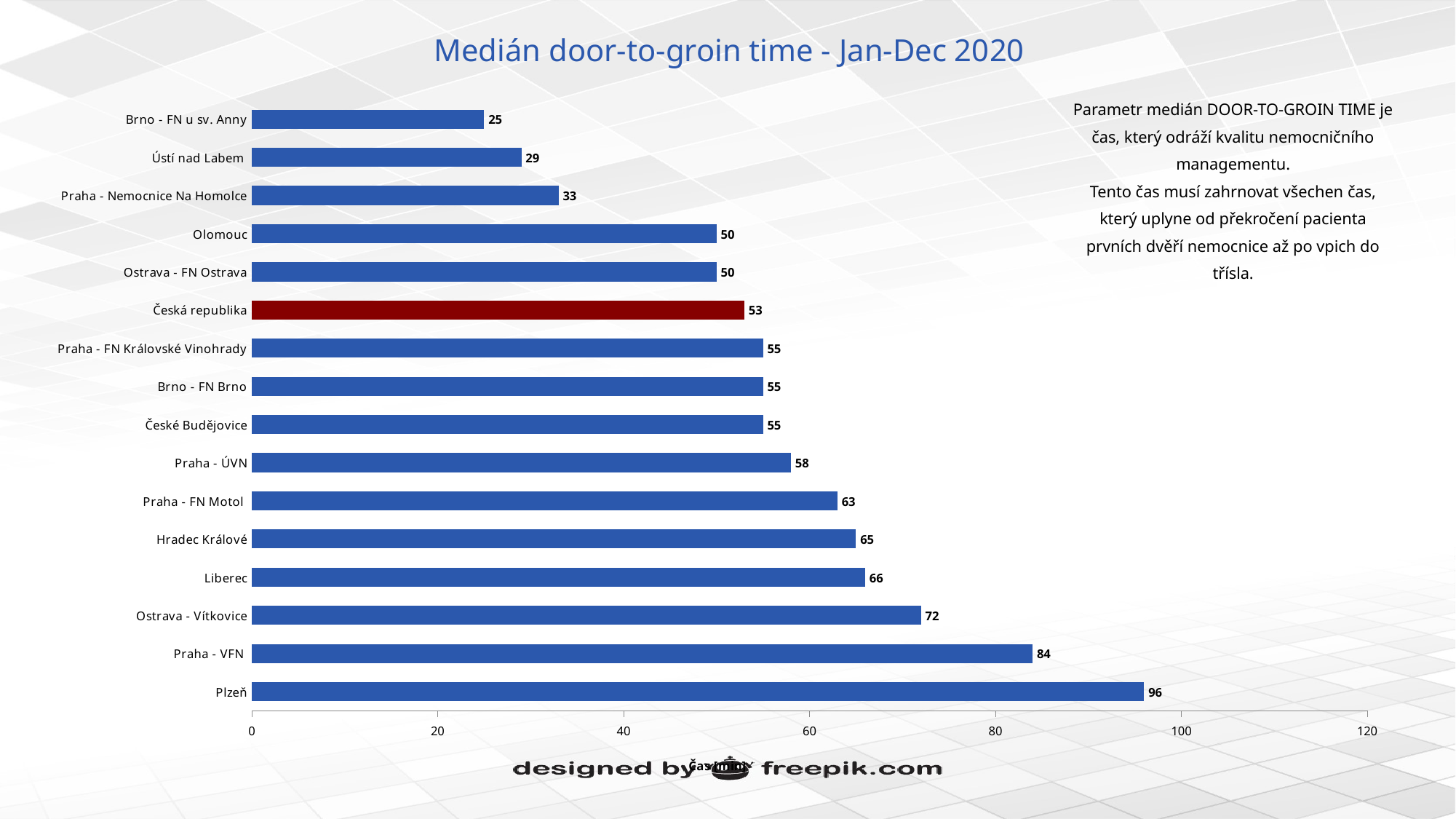
What is the difference between the values for Plzeň and Praha - VFN? 12 Which category has the highest median door-to-groin time? Plzeň Is the value for Praha - VFN greater or less than 80? greater Which is larger, the value for Liberec or the value for Hradec Králové? Liberec What is the difference between the values for Ostrava - Vítkovice and Česká republika? 19 What is the median door-to-groin time for Plzeň? 96 What is the value for Praha - FN Motol? 63 How many categories are shown in the chart? 16 Which category has the lowest median door-to-groin time? Brno - FN u sv. Anny What is the value shown for Česká republika? 53 What kind of chart is shown on the slide? Bar chart Which bar is shown in a different colour (dark red) from the others? Česká republika